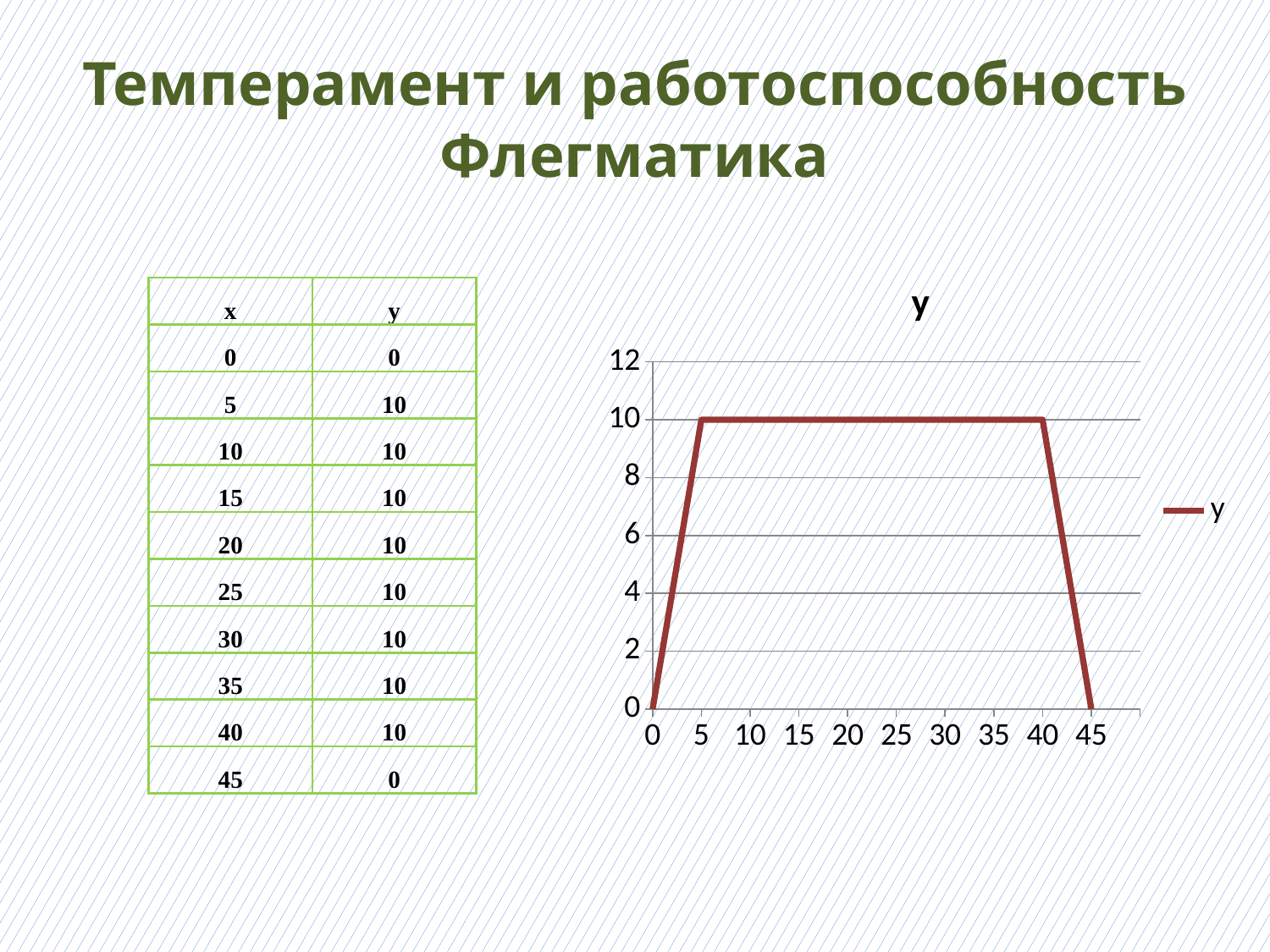
What kind of chart is shown on the slide? line chart How many series does the chart legend list? 1 Does the value of y rise or fall between x = 40 and x = 45? fall What is the value of y at x = 45? 0 How many data points are plotted on the chart? 10 What is the title of the chart? y Which is larger, the value of y at x = 10 or at x = 45? x = 10 What is the value of y at x = 0? 0 What is the difference between the value of y at x = 20 and at x = 45? 10 What is the highest value of y shown on the chart? 10 What is the lowest value of y shown on the chart? 0 What is the value of y at x = 5? 10